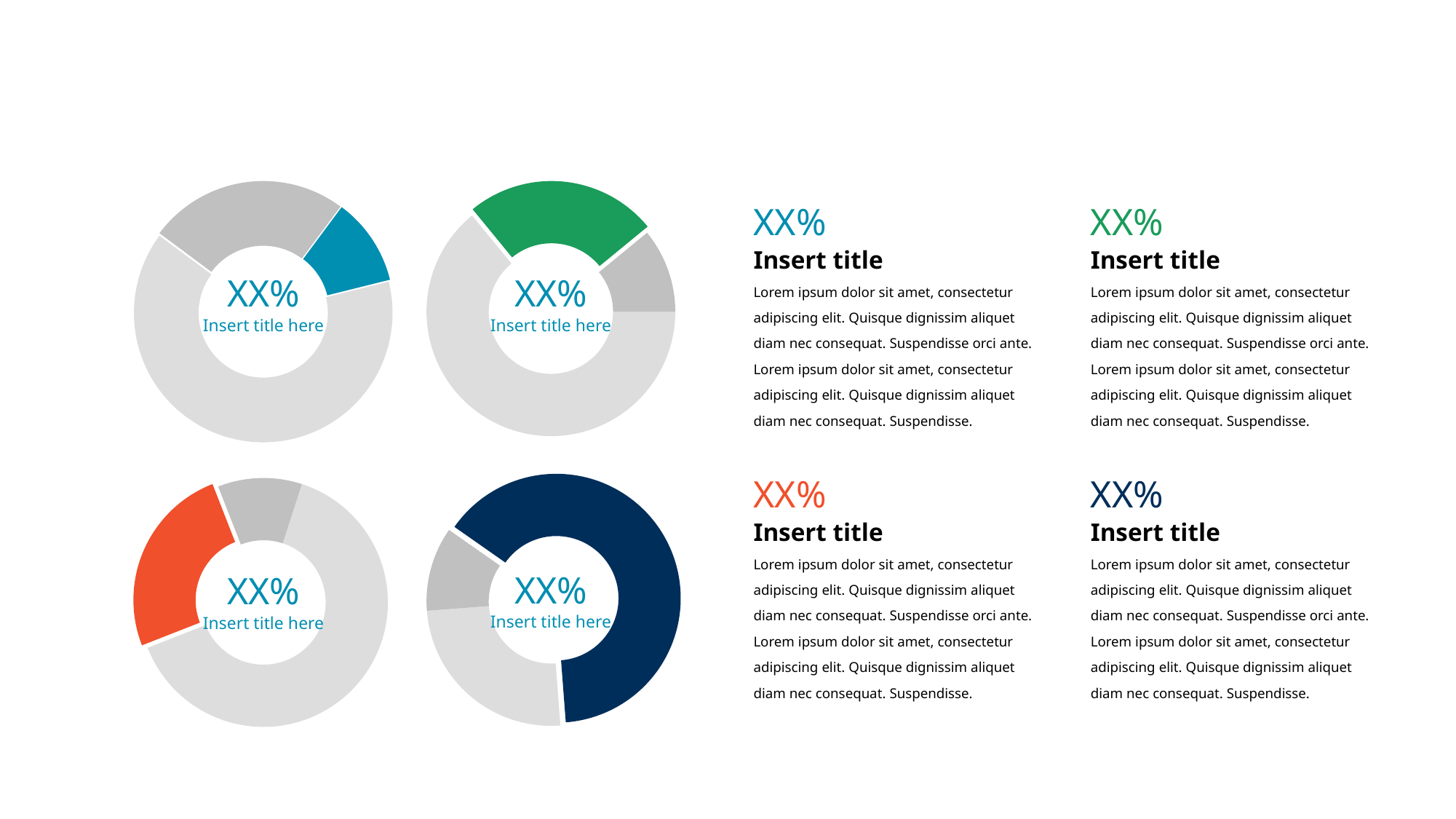
What kind of chart is the top-left chart on the slide? Donut chart How many donut charts are shown on the slide? 4 How many slices does the top-left donut chart have? 3 In the bottom-right donut chart, which slice is the largest: the navy, the light grey, or the dark grey one? Navy In the bottom-left donut chart, which slice is larger: the orange one or the dark grey one? Orange What kind of chart is the bottom-right chart on the slide? Donut chart What colour is the highlighted slice in the top-right donut chart? Green What percentage text is printed in the centre of the top-right donut chart? XX% In the top-left donut chart, which slice is the smallest: the blue, the light grey, or the dark grey one? Blue How many slices does the bottom-right donut chart have? 3 What colour is the highlighted slice in the bottom-left donut chart? Orange